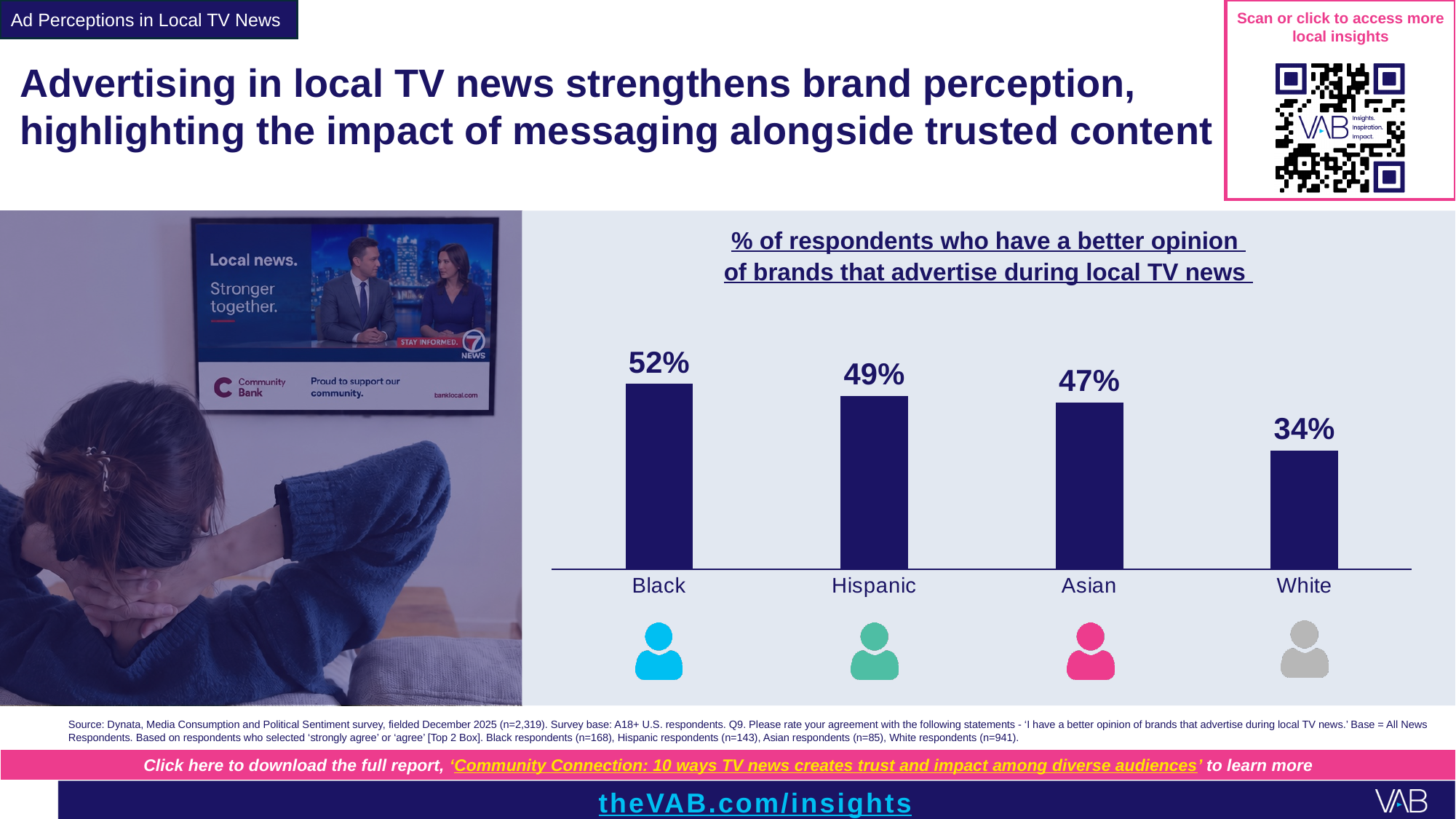
What is the value shown for Hispanic respondents? 49% What is the value shown for Asian respondents? 47% What is the difference between the Hispanic and Asian values? 2 percentage points How many groups are shown in the chart? 4 What percentage of Black respondents have a better opinion of brands that advertise during local TV news? 52% What kind of chart is shown on the slide? Bar chart Which is larger, the value for Hispanic respondents or the value for White respondents? Hispanic Which group has the highest percentage of respondents with a better opinion of brands that advertise during local TV news? Black Which group has the lowest percentage in the chart? White Do the values rise or fall moving from left to right across the chart? Fall What is the value shown for White respondents? 34% What is the difference in percentage points between Black and White respondents? 18 percentage points